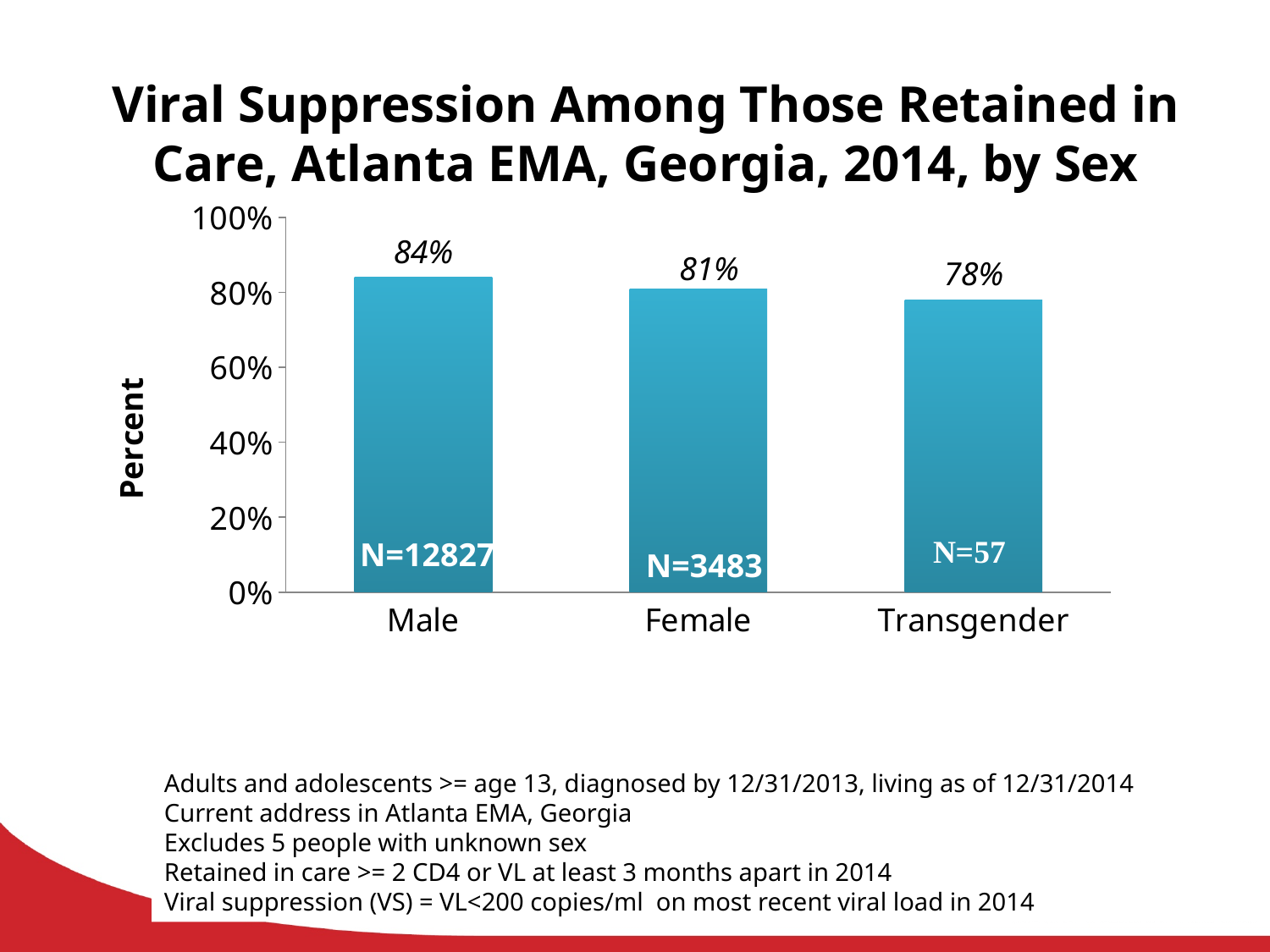
Is the value for Transgender greater or less than 80%? less What is the viral suppression percentage for Transgender? 78% What type of chart is shown on the slide? Bar chart What is the difference in viral suppression percentage between Male and Transgender? 6% Which has a higher viral suppression percentage, Female or Transgender? Female What is the difference in viral suppression percentage between Male and Female? 3% What is the viral suppression percentage for Male? 84% What is the N (sample size) shown for the Female bar? N=3483 How many sex categories are shown in the chart? 3 Which sex category has the highest viral suppression percentage? Male What is the viral suppression percentage for Female? 81% Which sex category has the lowest viral suppression percentage? Transgender